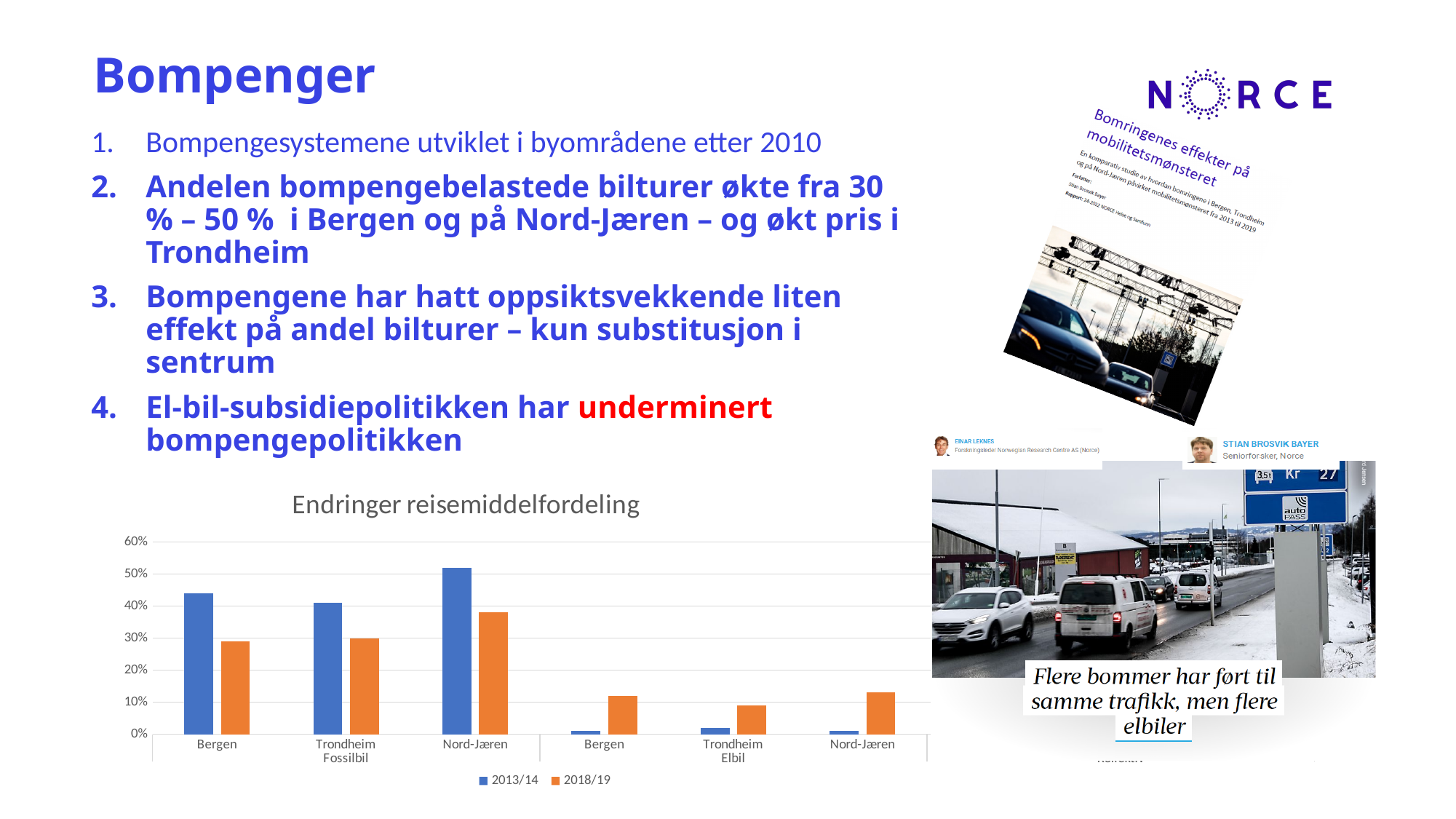
What are the two legend entries in the 'Endringer reisemiddelfordeling' chart? 2013/14 and 2018/19 In the 'Endringer reisemiddelfordeling' chart, is the 2013/14 value for Nord-Jæren under Fossilbil greater or less than 40%? greater In the 'Endringer reisemiddelfordeling' chart, is the 2018/19 value for Nord-Jæren under Elbil greater or less than 20%? less In the 'Endringer reisemiddelfordeling' chart, which category has the highest 2013/14 bar? Nord-Jæren (Fossilbil) In the 'Endringer reisemiddelfordeling' chart, is the 2018/19 value for Bergen under Fossilbil greater or less than 40%? less How many series does the legend of the 'Endringer reisemiddelfordeling' chart list? 2 In the 'Endringer reisemiddelfordeling' chart, for Bergen under Fossilbil, which series has the larger value, 2013/14 or 2018/19? 2013/14 In the 'Endringer reisemiddelfordeling' chart, for Bergen under Elbil, which series has the larger value, 2013/14 or 2018/19? 2018/19 What kind of chart is 'Endringer reisemiddelfordeling'? bar chart What is the title of the chart at the bottom left of the slide? Endringer reisemiddelfordeling